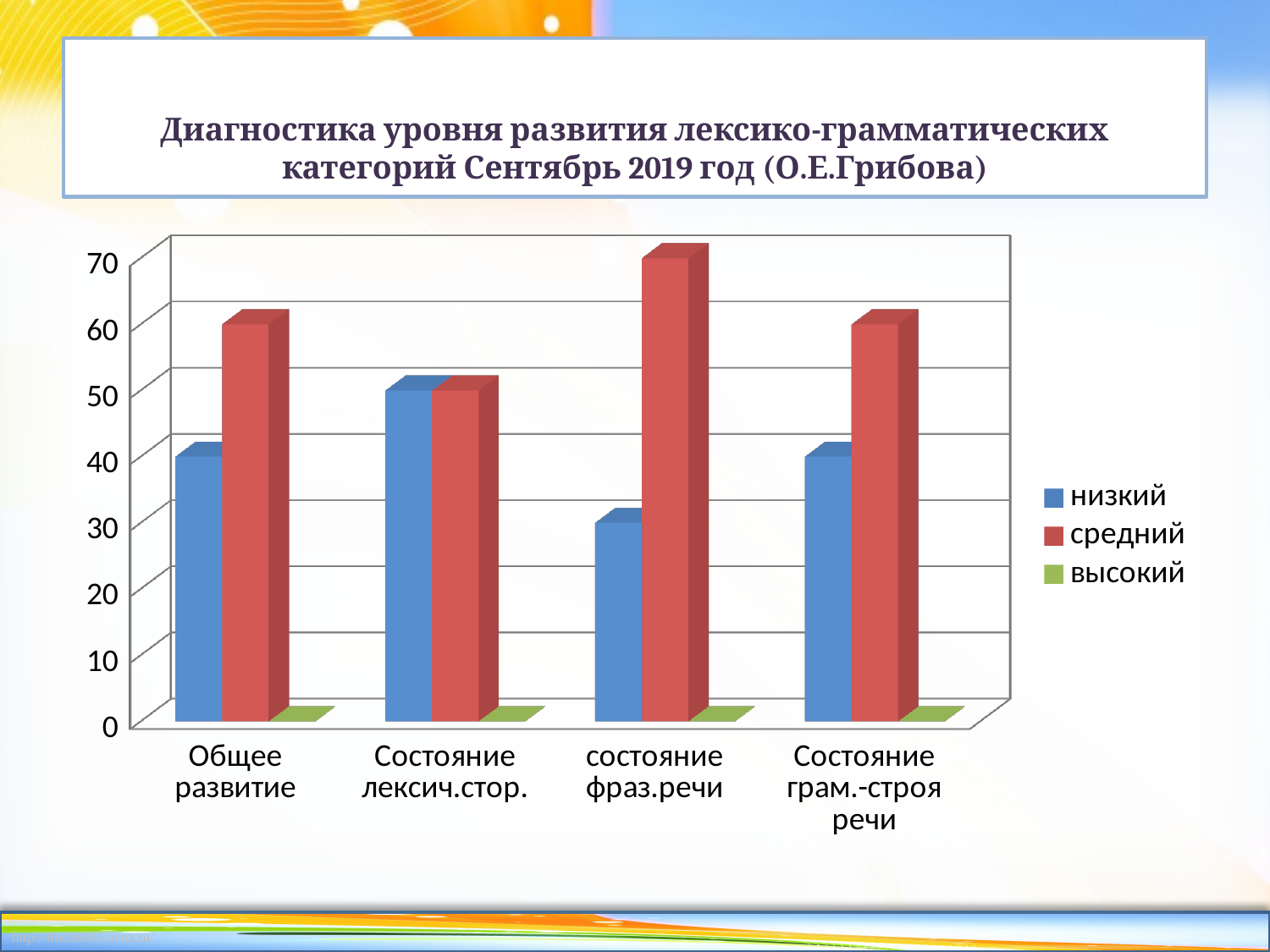
Which category has the highest value for the средний series? состояние фраз.речи Is the value of the низкий series for состояние фраз.речи greater or less than 40? less How many series does the legend list? 3 What is the value of the низкий series for Общее развитие? 40 For Общее развитие, which is larger: низкий or средний? средний For Общее развитие, what is the difference between the средний value and the низкий value? 20 What kind of chart is shown on the slide? bar chart Which category has the lowest value for the низкий series? состояние фраз.речи How many categories are shown along the x axis? 4 Is the value of the средний series for Состояние грам.-строя речи greater or less than 50? greater What is the value of the средний series for состояние фраз.речи? 70 What are the three entries listed in the legend? низкий, средний, высокий